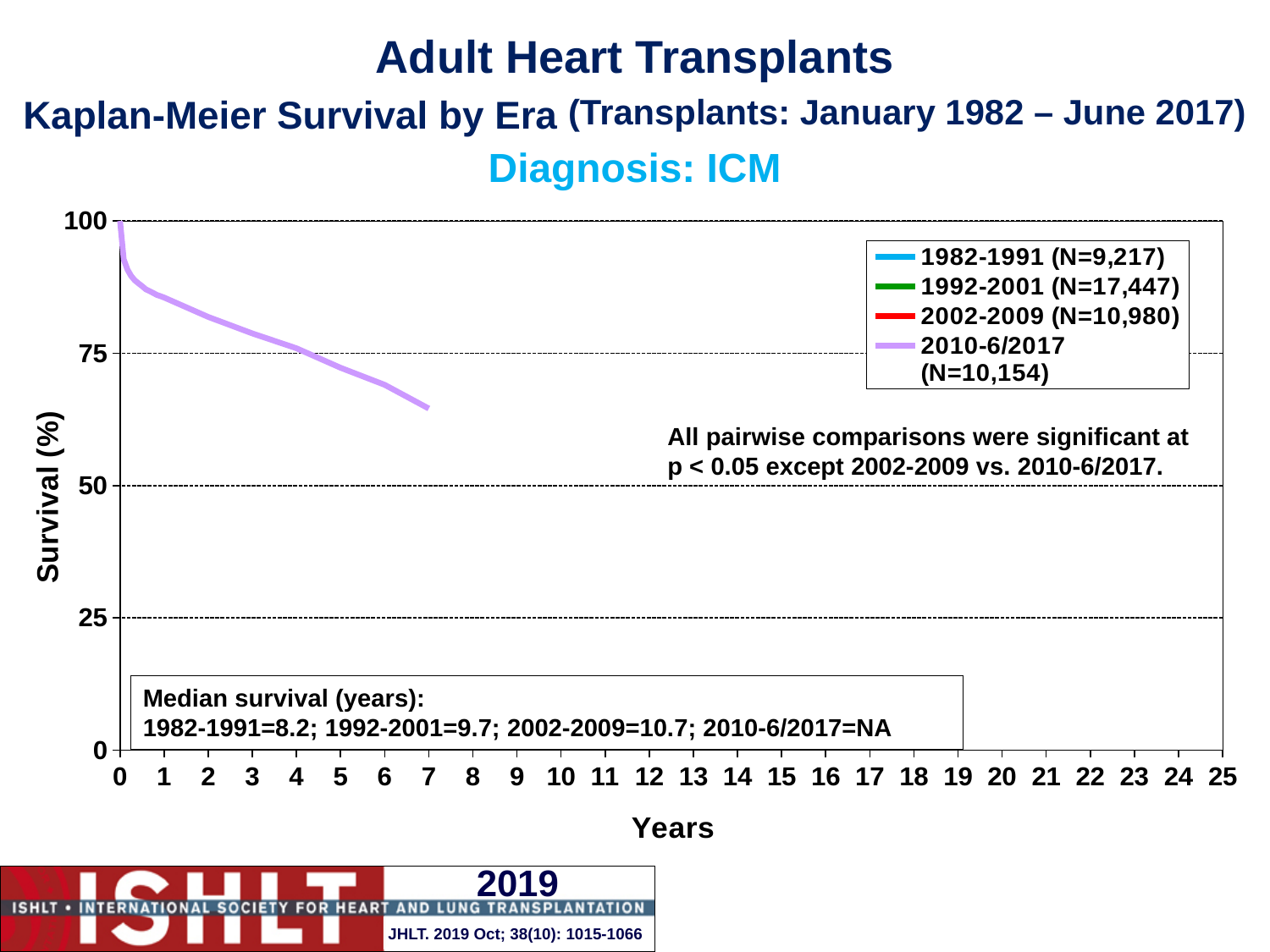
Which era has the smallest N in the legend? 1982-1991 What is the label of the y axis? Survival (%) What is the median survival in years for the 2010-6/2017 era? NA How many series does the legend list? 4 What kind of chart is shown on the slide? line chart What is the difference in median survival (years) between the 2002-2009 era and the 1982-1991 era? 2.5 Is the survival value for the 2010-6/2017 curve at year 7 greater or less than 75? less What is the median survival in years for the 2002-2009 era? 10.7 Which era has the largest N in the legend? 1992-2001 What is the N for the 1992-2001 era shown in the legend? 17,447 What is the N for the 2010-6/2017 era shown in the legend? 10,154 Does the plotted 2010-6/2017 survival curve rise or fall as years increase? fall